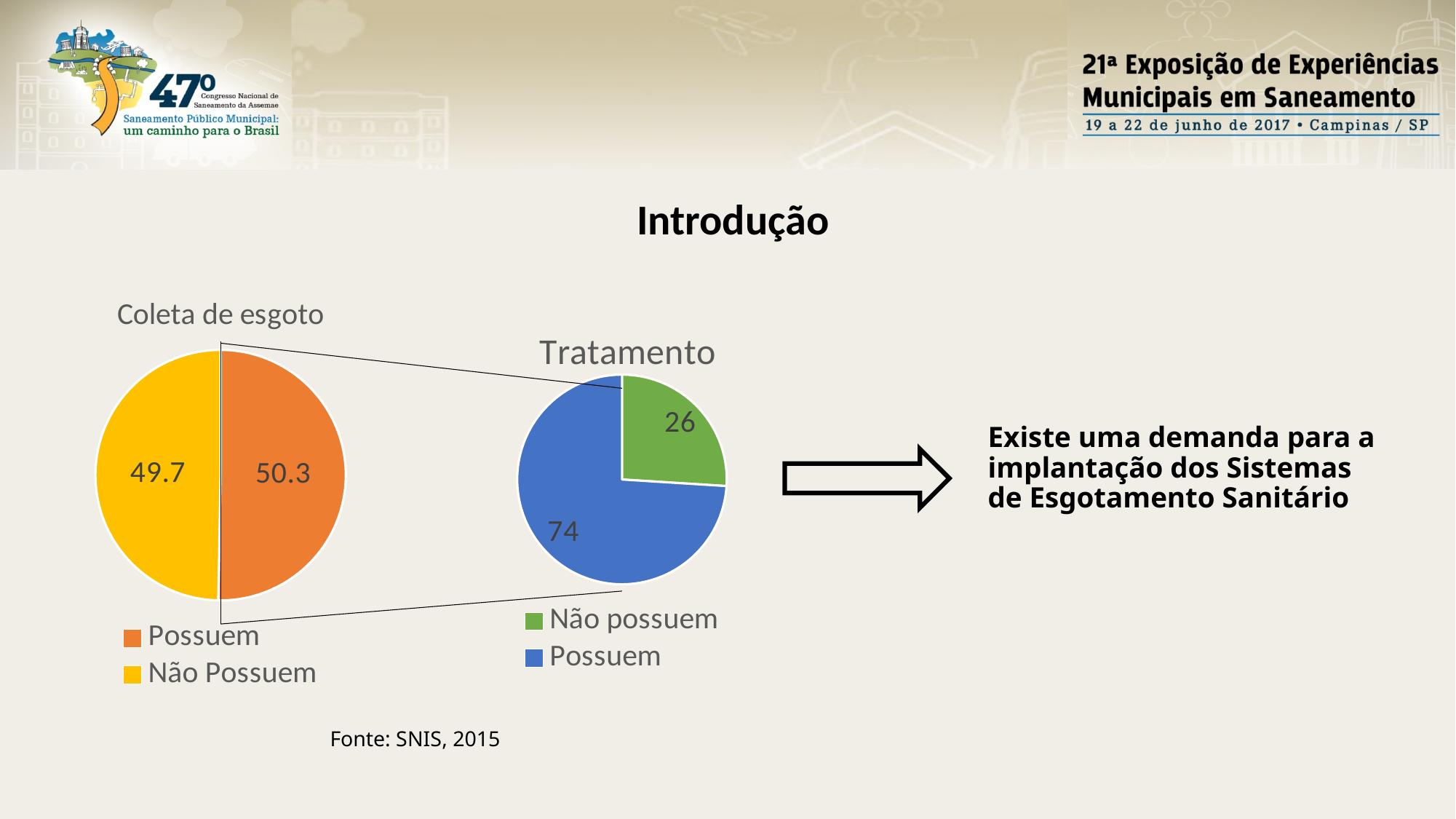
What kind of chart is the "Coleta de esgoto" chart? pie chart In the "Tratamento" chart, which category has the largest slice? Possuem How many slices does the "Tratamento" pie chart have? 2 In the "Tratamento" chart, what is the difference between Possuem and Não possuem? 48 In the "Tratamento" chart, what is the value for Possuem? 74 In the "Coleta de esgoto" chart, what colour is the Não Possuem slice? yellow In the "Coleta de esgoto" chart, what is the value for Possuem? 50.3 In the "Coleta de esgoto" chart, which is larger, Possuem or Não Possuem? Possuem In the "Tratamento" chart, which category has the smallest slice? Não possuem In the "Tratamento" chart, what is the value for Não possuem? 26 In the "Coleta de esgoto" chart, what is the value for Não Possuem? 49.7 In the "Coleta de esgoto" chart, what is the difference between Possuem and Não Possuem? 0.6